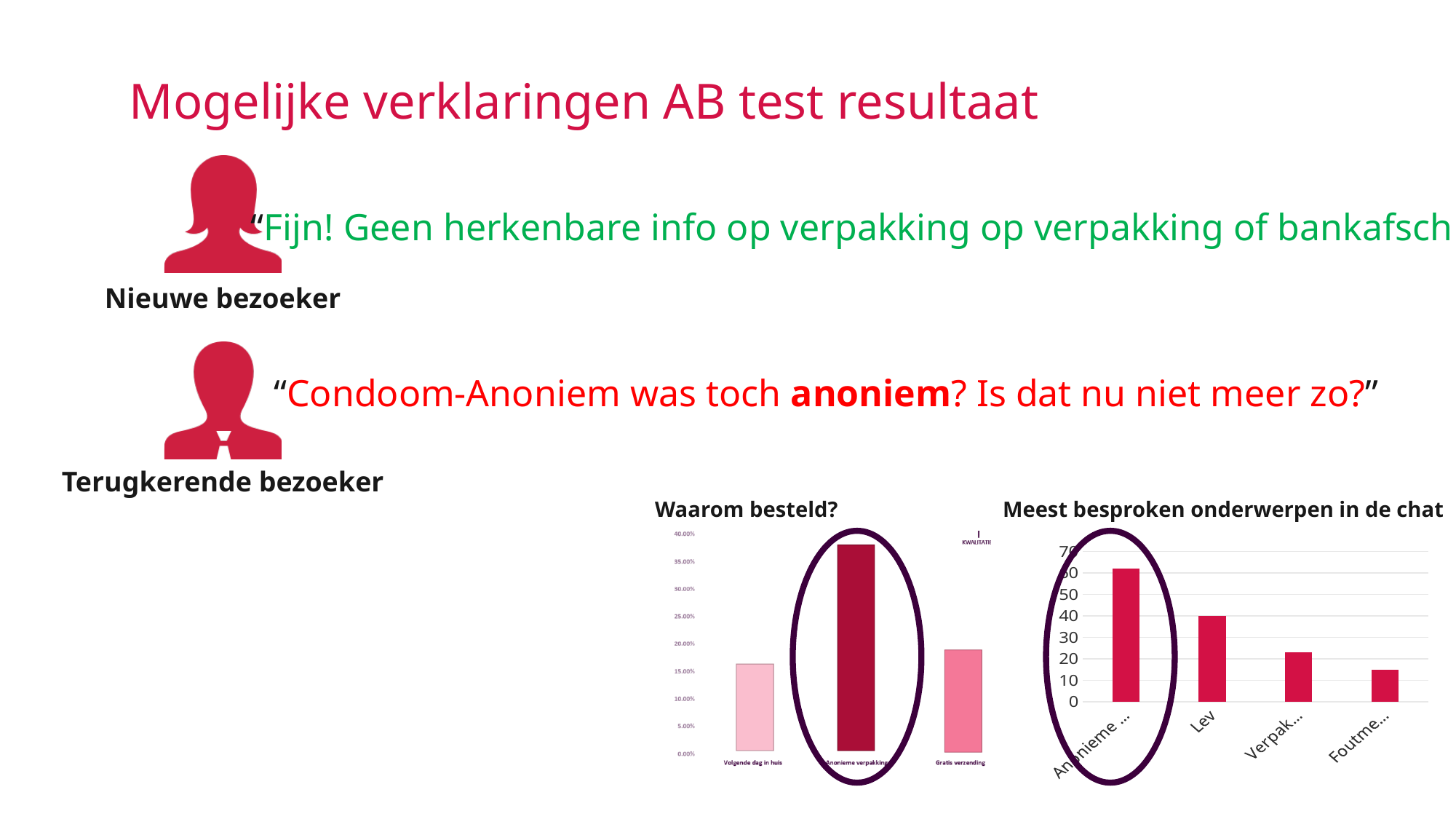
What is the title of the chart on the right side of the slide? Meest besproken onderwerpen in de chat In the 'Meest besproken onderwerpen in de chat' chart, do the values rise or fall from left to right? fall In the 'Meest besproken onderwerpen in de chat' chart, is the value for Lev greater or less than 30? greater In the 'Waarom besteld?' chart, is the value for Anonieme verpakking greater or less than 35.00%? greater In the 'Meest besproken onderwerpen in de chat' chart, is the value for the first bar (Anonieme ...) greater or less than 50? greater In the 'Waarom besteld?' chart, which category has the highest bar? Anonieme verpakking In the 'Waarom besteld?' chart, how many categories are shown? 3 What kind of chart is 'Meest besproken onderwerpen in de chat'? bar chart In the 'Waarom besteld?' chart, which is larger: Gratis verzending or Volgende dag in huis? Gratis verzending In the 'Waarom besteld?' chart, which category has the lowest bar? Volgende dag in huis In the 'Meest besproken onderwerpen in de chat' chart, how many bars are shown? 4